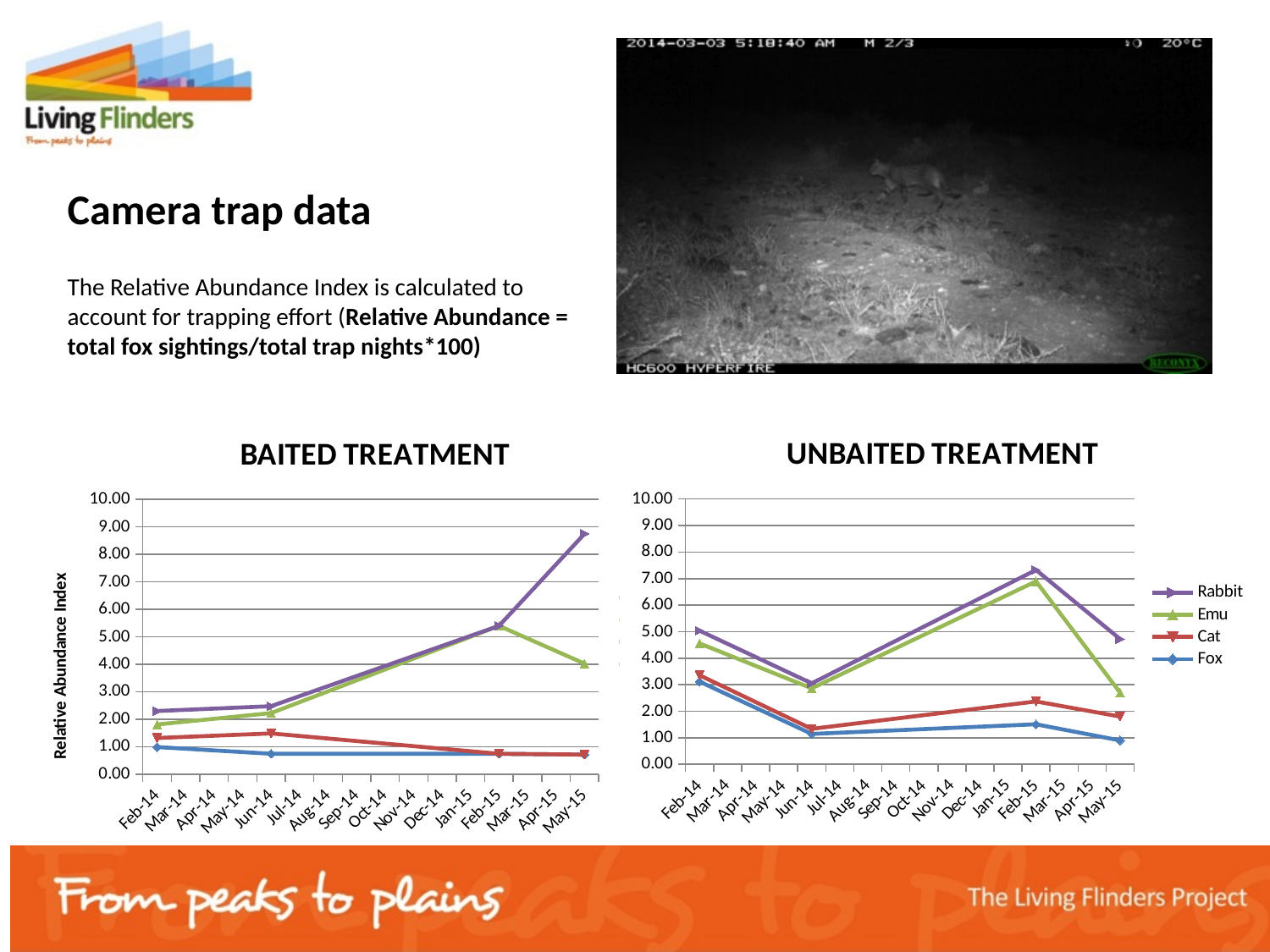
In the UNBAITED TREATMENT chart, is the Emu value at May-15 greater or less than 3.00? less In the UNBAITED TREATMENT chart, which series has the lowest value at May-15? Fox Which series are listed in the legend of the UNBAITED TREATMENT chart? Rabbit, Emu, Cat, Fox In the BAITED TREATMENT chart, which series has the highest value at May-15? Rabbit What kind of chart is the BAITED TREATMENT chart? Line chart In the UNBAITED TREATMENT chart, is the Rabbit value at Feb-15 greater or less than 7.00? greater In the BAITED TREATMENT chart, how many data points are plotted for the Rabbit series? 4 How many series does the legend list for the UNBAITED TREATMENT chart? 4 What is the y-axis title of the BAITED TREATMENT chart? Relative Abundance Index In the BAITED TREATMENT chart, is the Rabbit value at May-15 greater or less than 8.00? greater In the BAITED TREATMENT chart, does the Rabbit series rise or fall from Feb-14 to May-15? rise